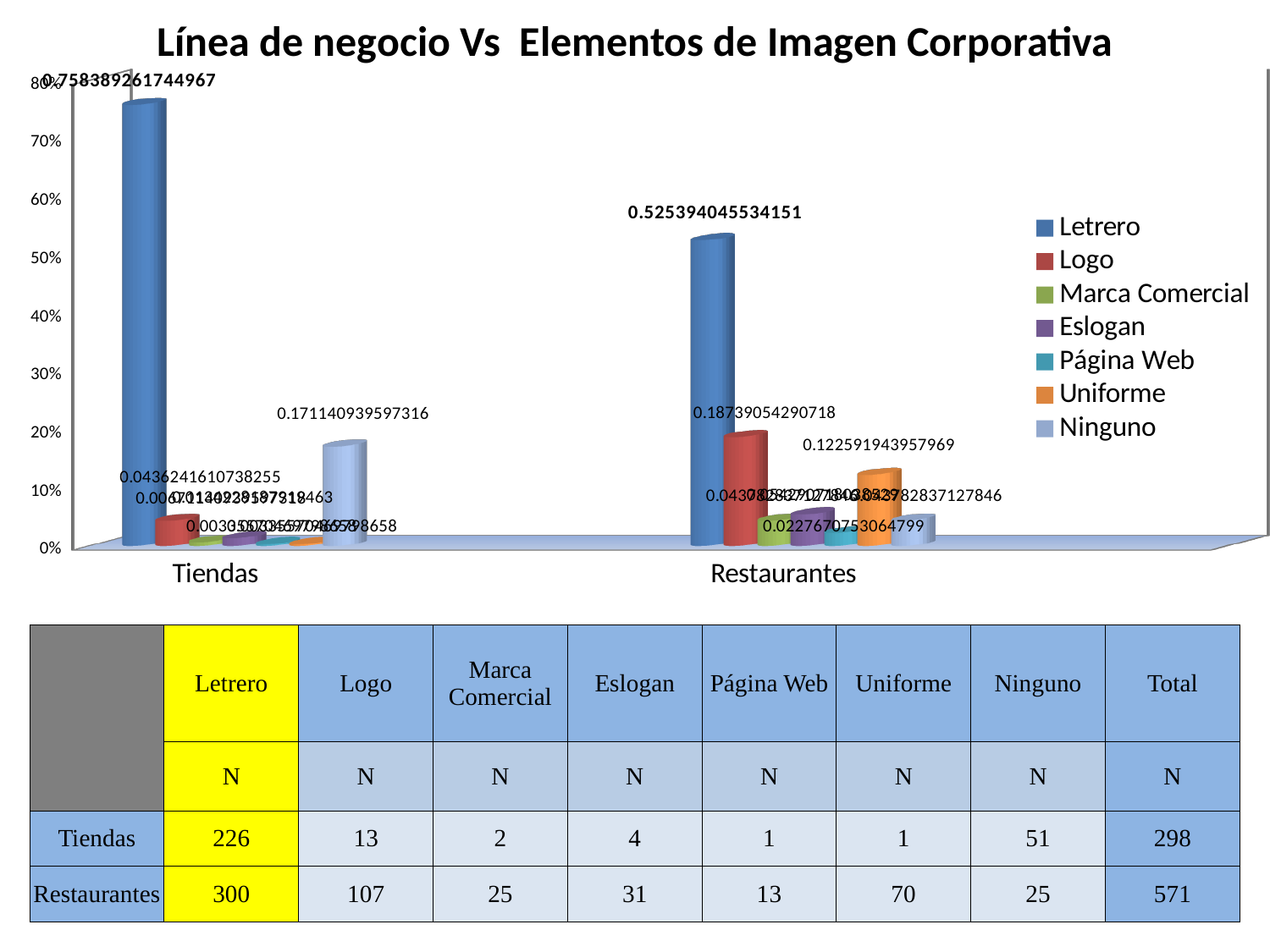
Which series has the highest value in the Tiendas category? Letrero What is the data label value for Letrero in the Tiendas category? 0.758389261744967 What is the data label value for Uniforme in the Restaurantes category? 0.122591943957969 What type of chart is shown on the slide? bar chart What is the data label value for Logo in the Restaurantes category? 0.18739054290718 Is the Letrero value for Tiendas greater or less than 70%? greater How many categories are shown on the x axis of the chart? 2 Which is larger, the Letrero value for Tiendas or the Letrero value for Restaurantes? Tiendas What is the data label value for Letrero in the Restaurantes category? 0.525394045534151 What is the title of the chart? Línea de negocio Vs Elementos de Imagen Corporativa How many series does the chart legend list? 7 What is the data label value for Ninguno in the Tiendas category? 0.171140939597316